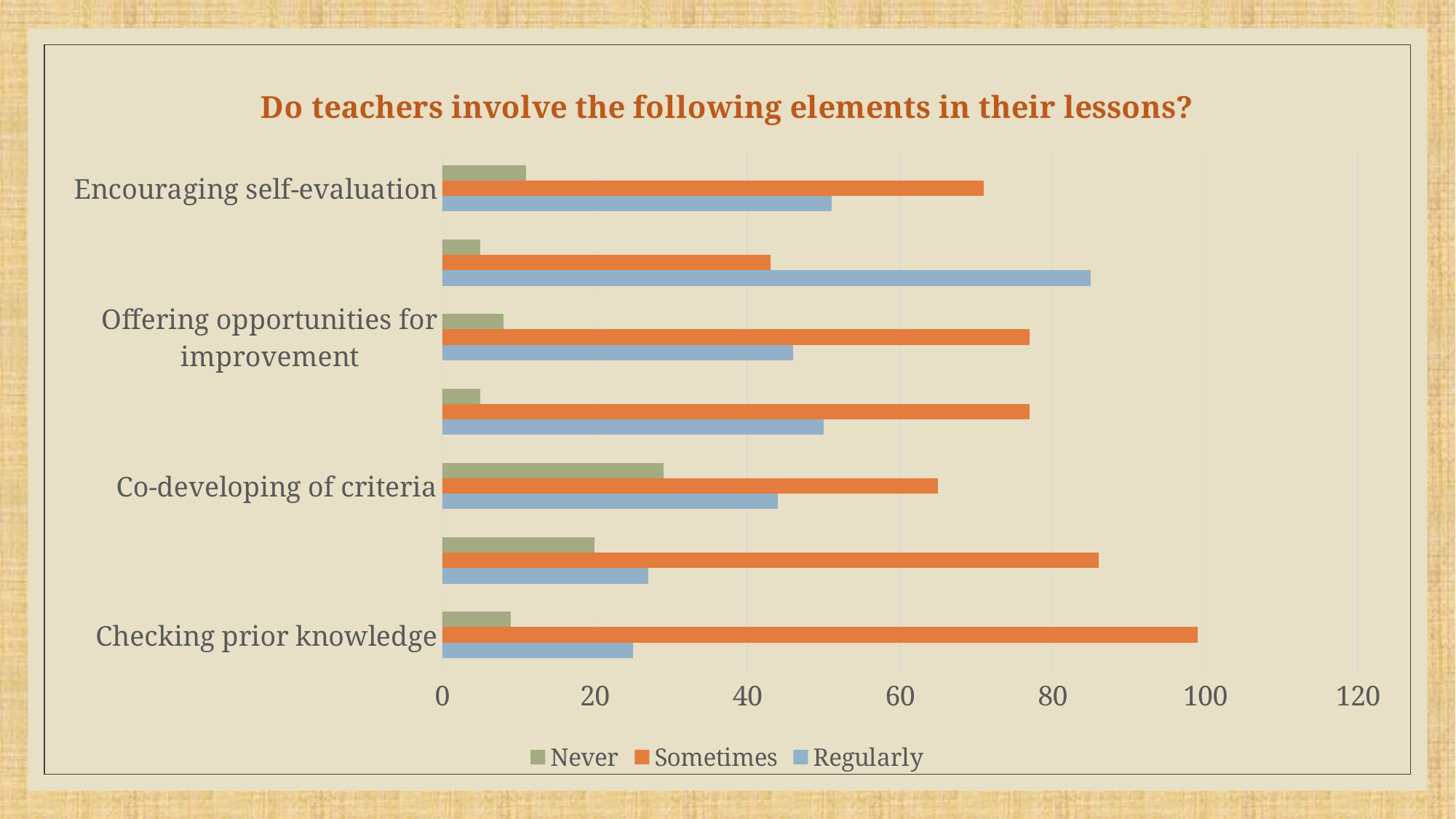
What kind of chart is shown on the slide? Bar chart Among the labelled categories, which has the highest Sometimes value? Checking prior knowledge How many series does the legend list? 3 What is the title of the chart? Do teachers involve the following elements in their lessons? For Encouraging self-evaluation, which is larger: the Sometimes value or the Regularly value? Sometimes Is the Sometimes value for Checking prior knowledge greater or less than 80? greater Is the Never value for Co-developing of criteria greater or less than 20? greater Is the Regularly value for Checking prior knowledge greater or less than 40? less Which series is shown in orange in the legend? Sometimes Which is larger: the Never value for Co-developing of criteria or the Never value for Checking prior knowledge? Co-developing of criteria